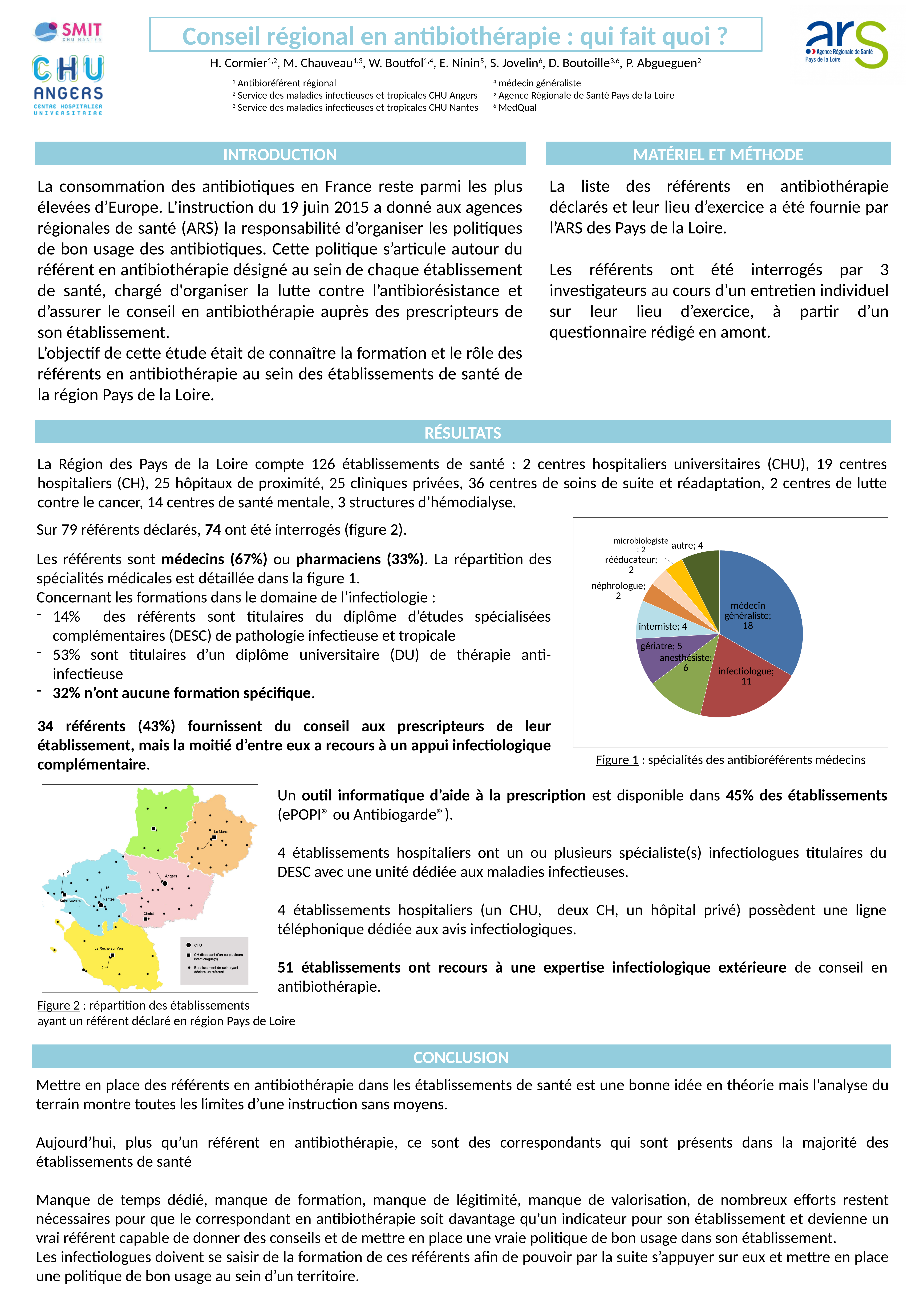
In the Figure 1 pie chart, what is the difference between the values for anesthésiste and gériatre? 1 In the Figure 1 pie chart, which specialty has the largest slice? médecin généraliste In the Figure 1 pie chart, what is the value for autre? 4 In the Figure 1 pie chart, what is the value for infectiologue? 11 In the Figure 1 pie chart, what is the value for anesthésiste? 6 In the Figure 1 pie chart, what is the difference between the values for médecin généraliste and infectiologue? 7 What is the caption of Figure 1? Figure 1 : spécialités des antibioréférents médecins In the Figure 1 pie chart, which is larger: gériatre or interniste? gériatre How many slices (categories) does the Figure 1 pie chart have? 9 What kind of chart is Figure 1? pie chart In the Figure 1 pie chart, what is the value for médecin généraliste? 18 In the Figure 1 pie chart, what is the smallest value shown on any slice? 2